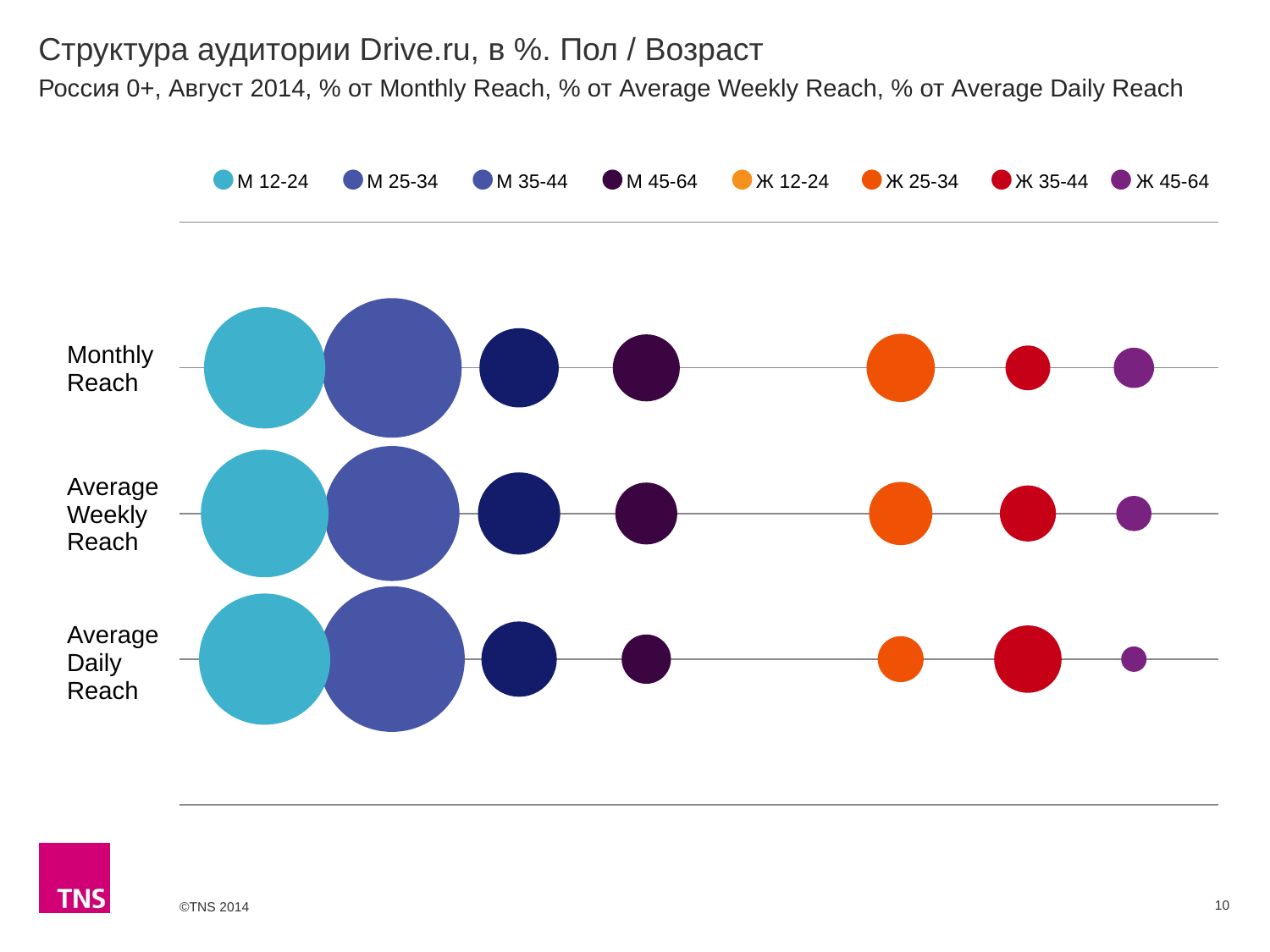
What is the title of the chart on the slide? Структура аудитории Drive.ru, в %. Пол / Возраст Which series has the largest bubble in the Monthly Reach row? М 25-34 In the Monthly Reach row, which bubble is larger: М 35-44 or Ж 35-44? М 35-44 In the Average Daily Reach row, which bubble is larger: Ж 25-34 or Ж 35-44? Ж 35-44 Does the Ж 45-64 bubble get larger or smaller going from Monthly Reach to Average Daily Reach? Smaller In the Monthly Reach row, which bubble is larger: М 12-24 or М 45-64? М 12-24 What colour represents the Ж 35-44 series in the legend? Red How many series does the legend list? 8 How many reach categories (rows) are plotted on the chart? 3 What kind of chart is shown on the slide? Bubble chart Does the Ж 35-44 bubble get larger or smaller going from Monthly Reach to Average Daily Reach? Larger Which series has the largest bubble in the Average Daily Reach row? М 25-34